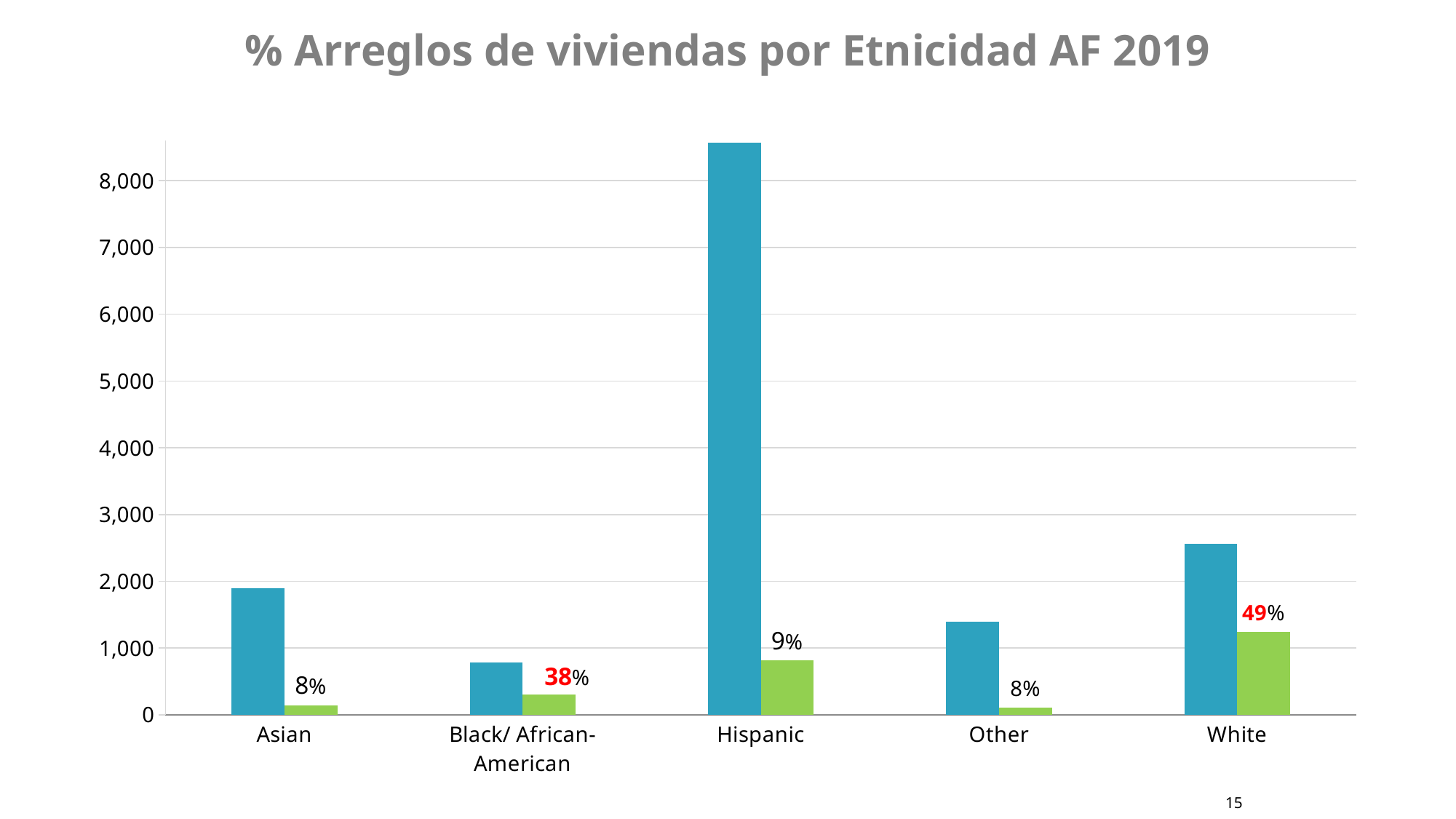
What percentage label is shown for the Hispanic category? 9% Which category has the shortest blue bar? Black/ African-American What percentage label is shown for the White category? 49% Is the blue bar for Hispanic greater or less than 8,000? greater What type of chart is shown on the slide? bar chart Which category has the tallest blue bar? Hispanic Which category has the highest percentage label? White Which percentage label is larger, Black/ African-American or Hispanic? Black/ African-American How many ethnicity categories are shown on the x axis? 5 What percentage label is shown for the Black/ African-American category? 38% What percentage label is shown for the Asian category? 8% What is the title of the chart? % Arreglos de viviendas por Etnicidad AF 2019